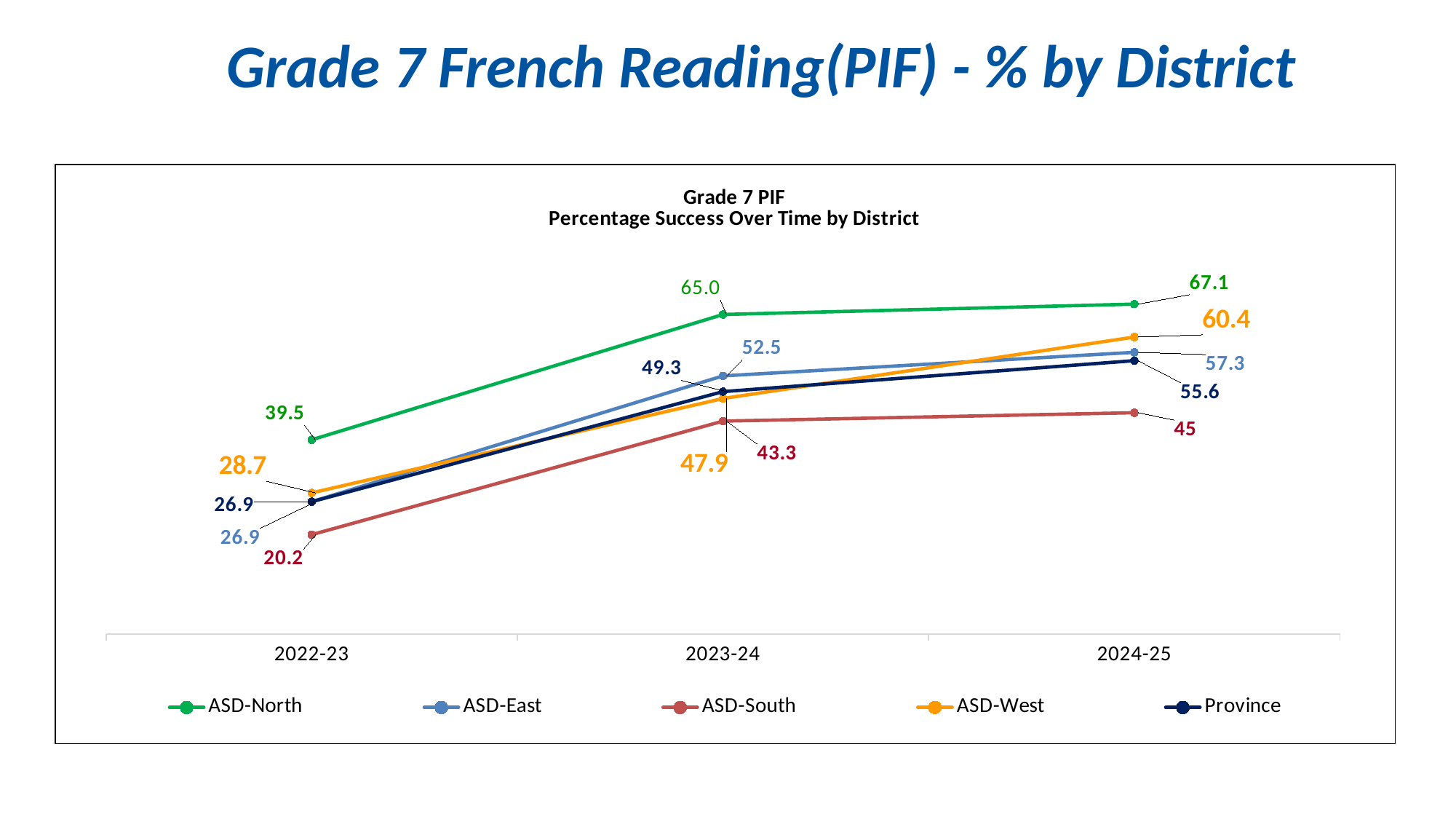
What is the value for ASD-West in 2023-24? 47.9 What type of chart is shown on the slide? Line chart Does the ASD-East line rise or fall from 2022-23 to 2024-25? Rises What is the Province value in 2024-25? 55.6 What is the difference between ASD-North and ASD-South in 2022-23? 19.3 In 2024-25, which is larger: ASD-West or ASD-East? ASD-West What is the value for ASD-South in 2022-23? 20.2 Which series has the lowest value in 2024-25? ASD-South How many series does the legend list? 5 What is the value for ASD-North in 2024-25? 67.1 How many school years are shown on the x axis? 3 Which district has the highest value in 2023-24? ASD-North